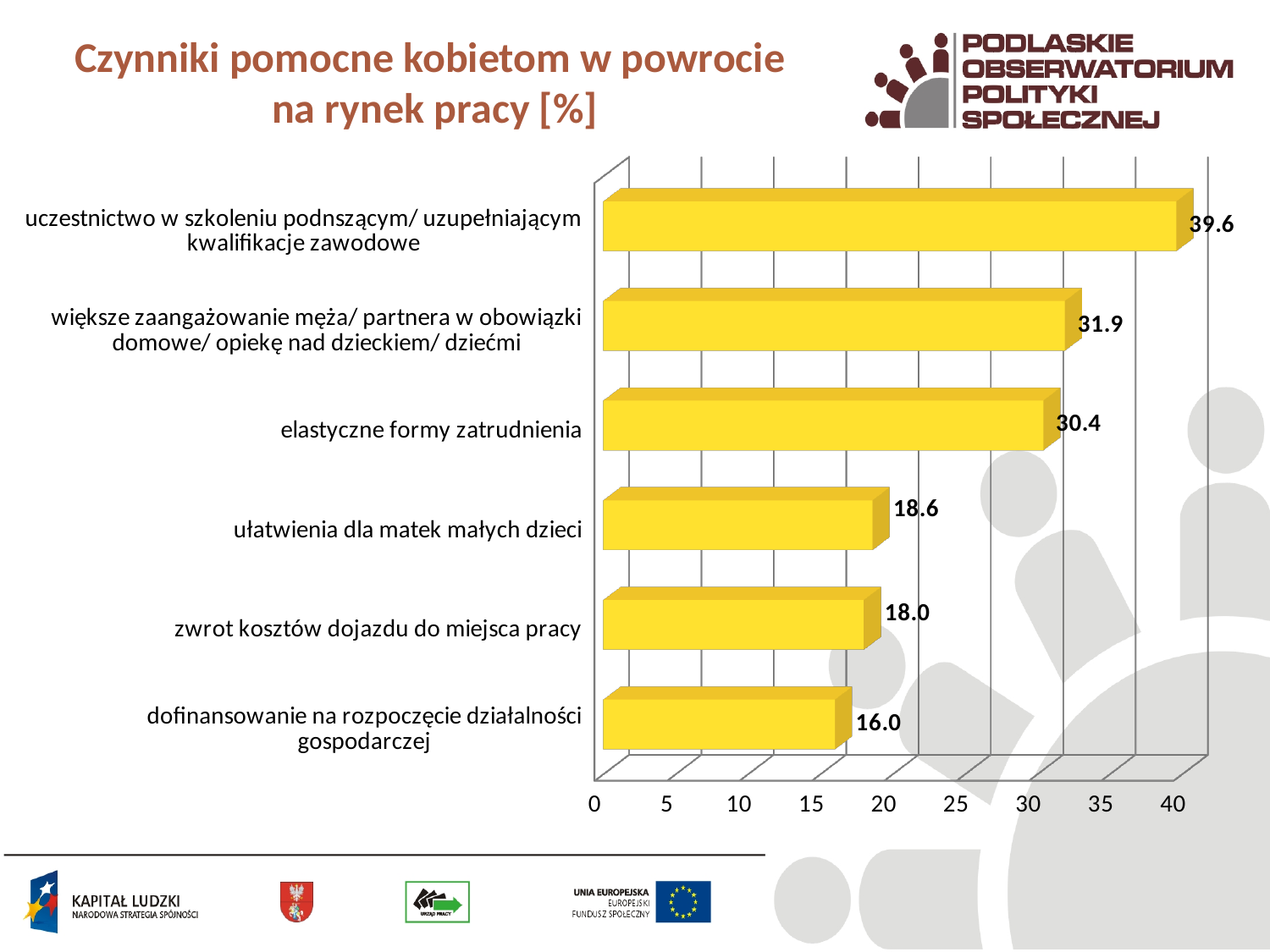
How many categories are shown in the chart? 6 What kind of chart is shown on the slide? bar chart What is the difference between the values for "uczestnictwo w szkoleniu podnoszącym/ uzupełniającym kwalifikacje zawodowe" and "dofinansowanie na rozpoczęcie działalności gospodarczej"? 23.6 Which category has the lowest value? dofinansowanie na rozpoczęcie działalności gospodarczej Which is larger: the value for "ułatwienia dla matek małych dzieci" or for "zwrot kosztów dojazdu do miejsca pracy"? ułatwienia dla matek małych dzieci Is the value for "elastyczne formy zatrudnienia" greater or less than 25? greater What is the difference between the values for "większe zaangażowanie męża/ partnera w obowiązki domowe/ opiekę nad dzieckiem/ dziećmi" and "elastyczne formy zatrudnienia"? 1.5 What is the title of the chart? Czynniki pomocne kobietom w powrocie na rynek pracy [%] What is the value for "elastyczne formy zatrudnienia"? 30.4 What is the value for "ułatwienia dla matek małych dzieci"? 18.6 What is the value for "zwrot kosztów dojazdu do miejsca pracy"? 18.0 Which category has the highest value? uczestnictwo w szkoleniu podnszącym/ uzupełniającym kwalifikacje zawodowe